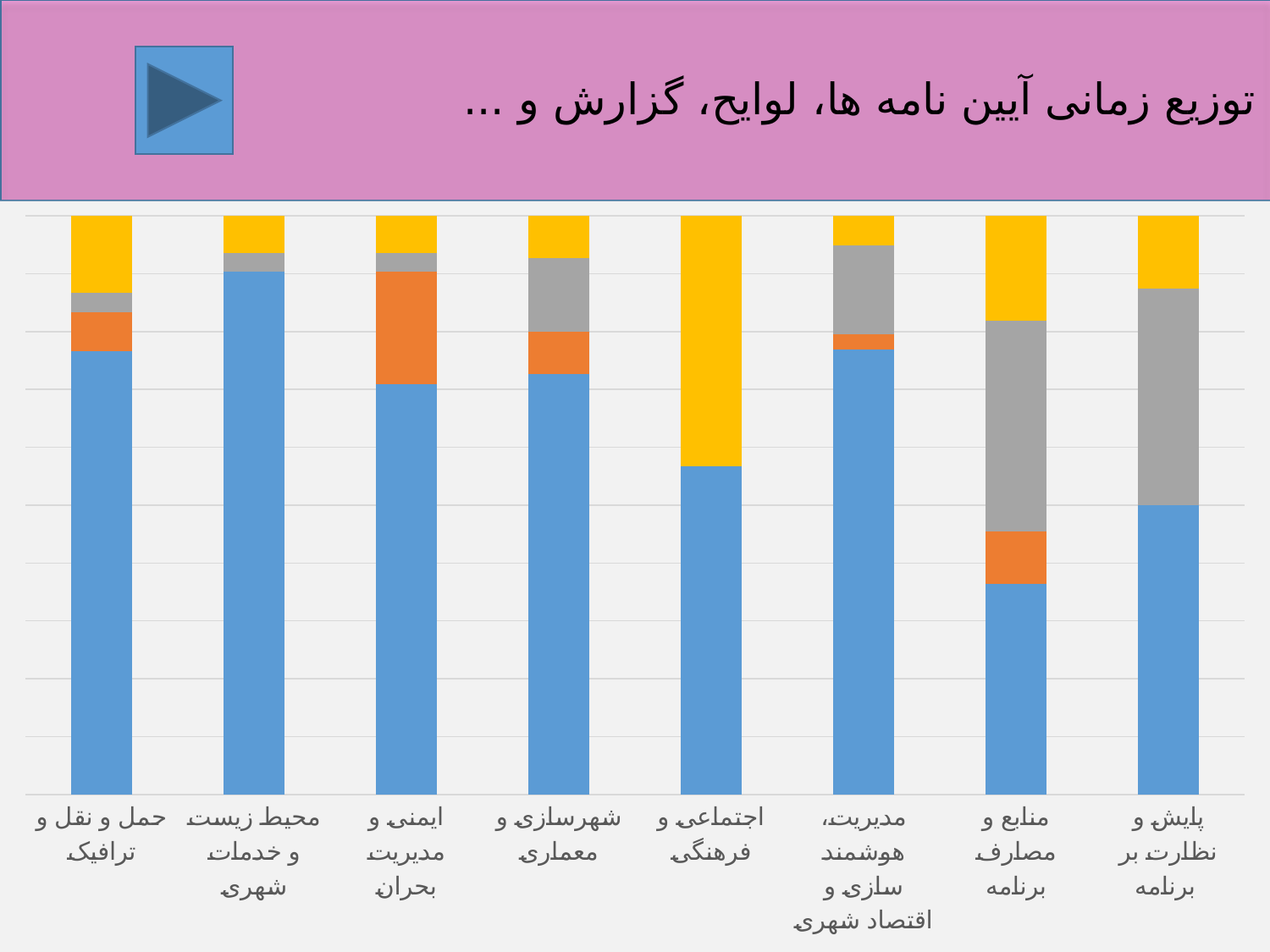
Which category has the largest gray segment? پایش و نظارت بر برنامه Which categories have no orange segment in their bar? محیط زیست و خدمات شهری, اجتماعی و فرهنگی and پایش و نظارت بر برنامه What is the title shown at the top of the slide? توزیع زمانی آیین نامه ها، لوایح، گزارش و ... Is the blue segment larger for اجتماعی و فرهنگی or for شهرسازی و معماری? شهرسازی و معماری Which category has the shortest blue segment? منابع و مصارف برنامه How many differently coloured segments make up each bar in the chart? 4 Which category has the largest orange segment? ایمنی و مدیریت بحران Which category has the tallest blue segment? محیط زیست و خدمات شهری How many categories are shown along the x axis of the chart? 8 What kind of chart is shown on the slide? Stacked bar chart Is the blue segment larger for حمل و نقل و ترافیک or for پایش و نظارت بر برنامه? حمل و نقل و ترافیک